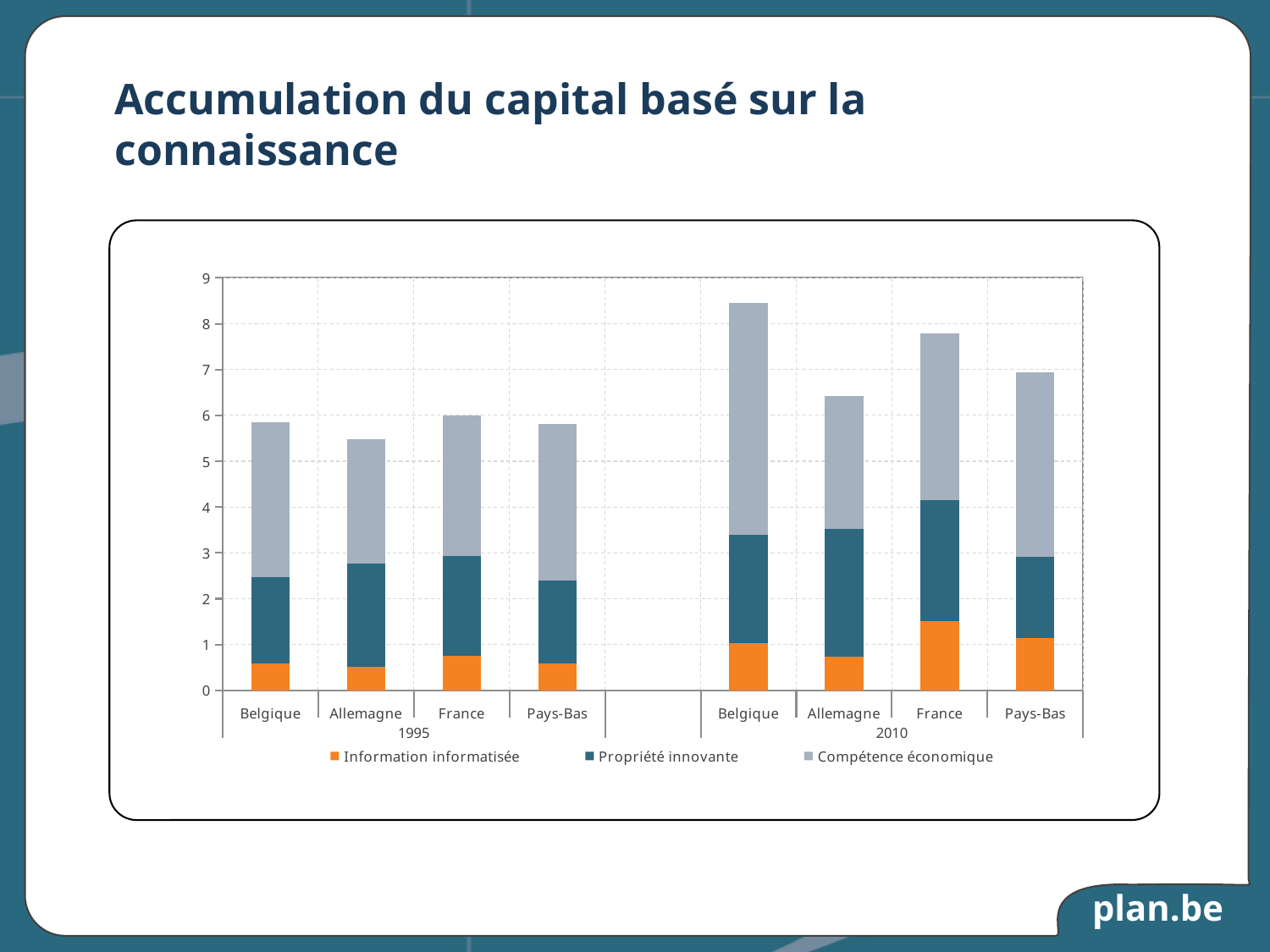
How many series does the legend list? 3 Do the total values for each country rise or fall from 1995 to 2010? rise How many bars are plotted in the chart? 8 Which bar has the highest total in the chart? Belgique 2010 Which bar has the lowest total in the chart? Allemagne 1995 What kind of chart is shown on the slide? Stacked bar chart Is the total for Allemagne in 1995 greater or less than 6? less Which has the larger total in 2010, France or Pays-Bas? France Which has the larger Information informatisée value in 2010, Belgique or France? France Is the total for Allemagne in 2010 greater or less than 6? greater Is the total for Belgique in 2010 greater or less than 8? greater Which series is shown in orange in the legend? Information informatisée